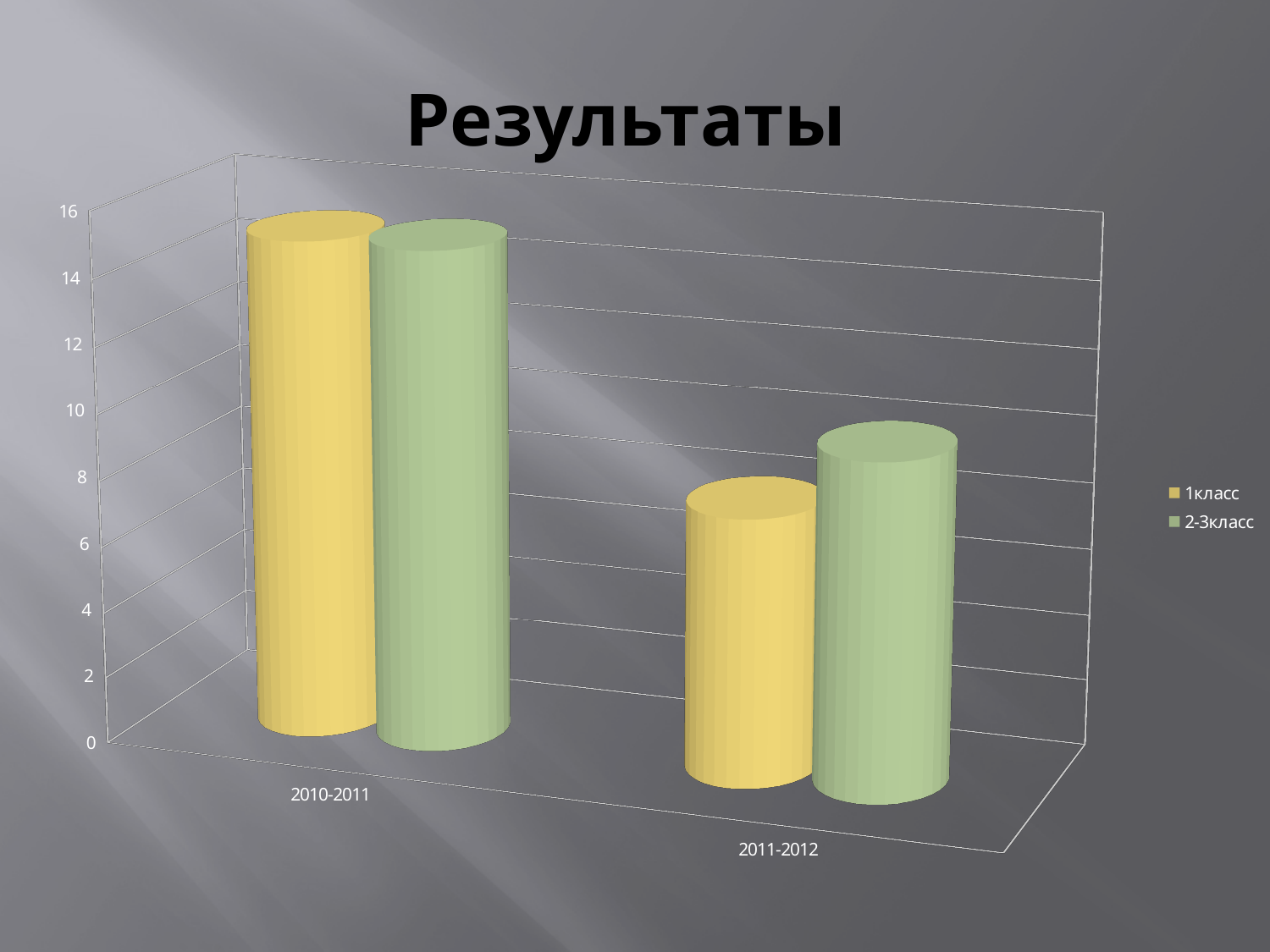
Do the values for 2-3класс rise or fall from 2010-2011 to 2011-2012? fall How many categories are shown on the x axis? 2 Is the value for 1класс in 2011-2012 greater or less than 12? less How many series does the legend list? 2 In 2011-2012, which series has the larger value, 1класс or 2-3класс? 2-3класс What kind of chart is shown on the slide? bar chart Is the value for 2-3класс in 2011-2012 greater or less than 6? greater For the 1класс series, which category has the highest value? 2010-2011 Which series is shown in green? 2-3класс Is the value for 2-3класс in 2010-2011 greater or less than 12? greater What is the title of the chart? Результаты